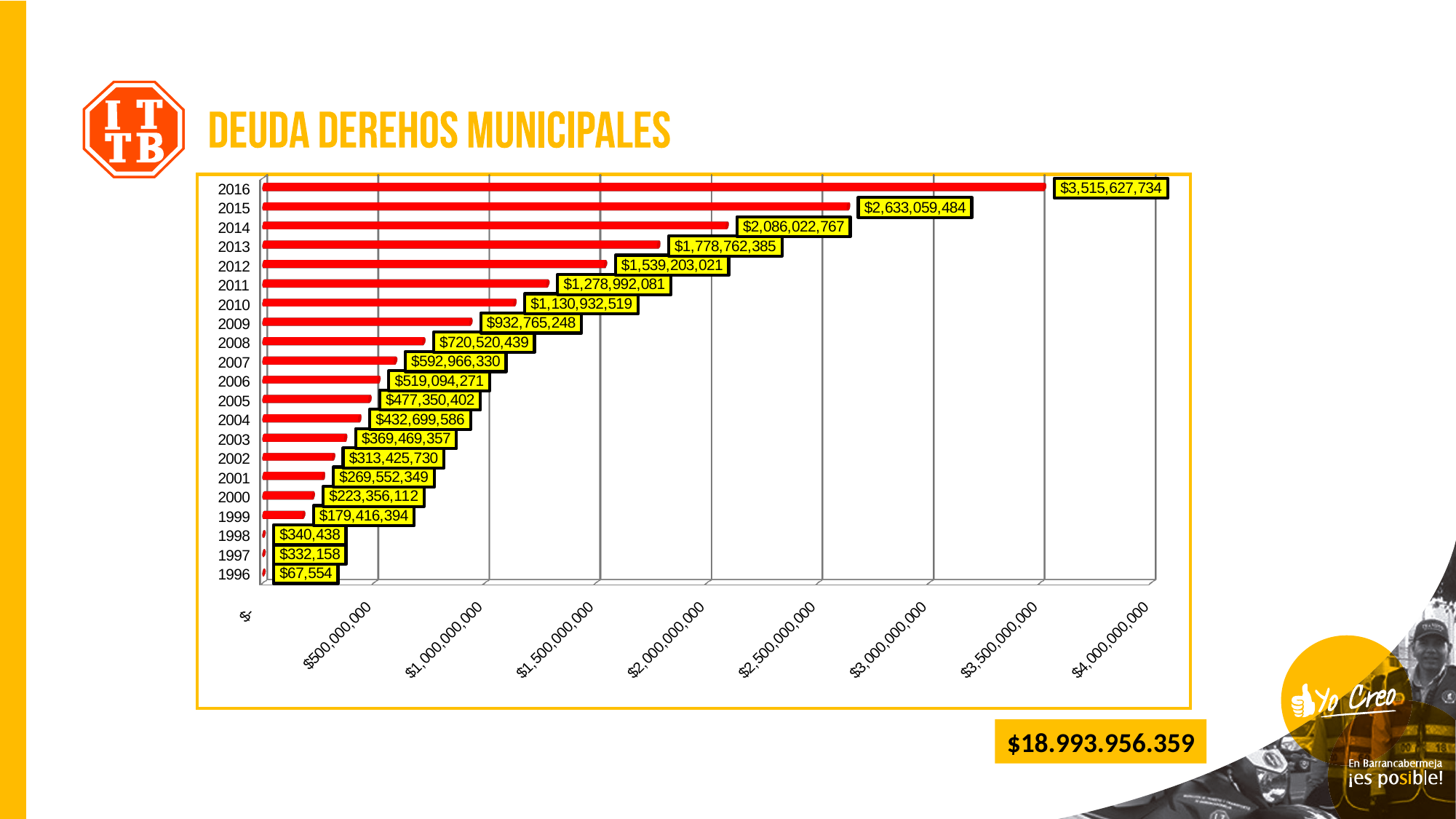
Which is larger, the value for 2010 or the value for 2011? 2011 What is the value for 2016? $3,515,627,734 What is the value for 1996? $67,554 What is the difference between the values for 2000 and 1999? $43,939,718 Which year has the lowest value? 1996 What is the value for 2003? $369,469,357 What is the value for 2009? $932,765,248 Is the value for 2013 greater or less than $1,500,000,000? greater How many years are shown in the chart? 21 What kind of chart is shown on the slide? bar chart What is the difference between the values for 2016 and 2015? $882,568,250 Which year has the highest value? 2016